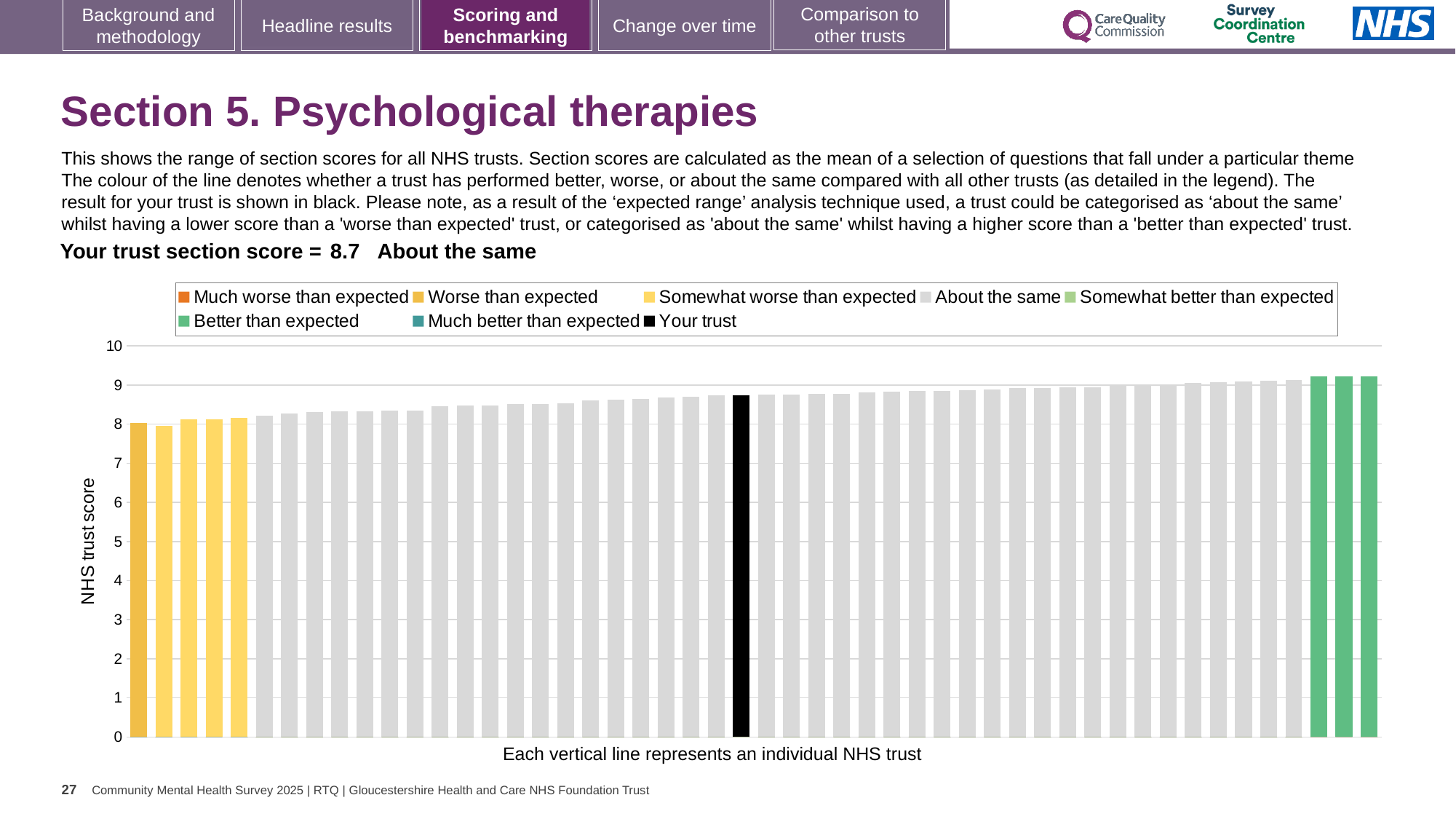
What colour is used for the bar representing your trust? black Is the value for your trust (the black bar) greater or less than 8? greater What kind of chart is shown on the slide? bar chart Do the bar values rise or fall from left to right across the chart? rise Which legend category do the highest bars on the chart belong to? Better than expected What is the section score for your trust shown on the slide? 8.7 Is the value for the rightmost bar greater or less than 9? greater Is the value for the leftmost bar greater or less than 9? less What is the label on the vertical axis of the chart? NHS trust score How many series does the legend list? 8 Which category is your trust placed in for this section? About the same How many bars are coloured green (Better than expected)? 3